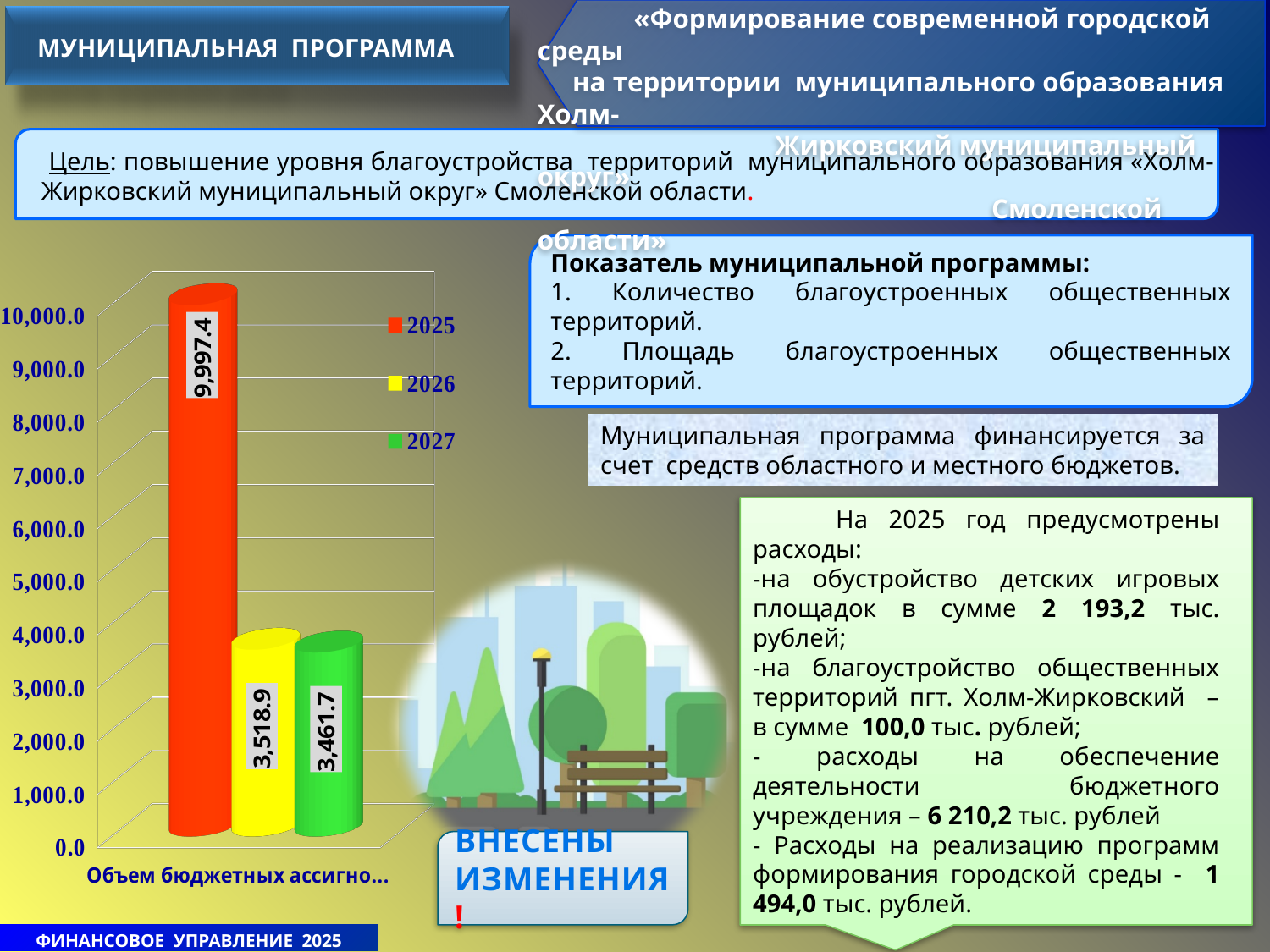
Which is larger, the value for 2025 or the value for 2027? 2025 What colour is the bar for 2026 in the chart? yellow How many series does the chart legend list? 3 What kind of chart is shown on the slide? bar chart Which year has the lowest value on the chart? 2027 What is the value for 2025 on the chart? 9,997.4 Which year has the highest value on the chart? 2025 Is the value for 2026 greater or less than 3,000.0? greater What is the value for 2027 on the chart? 3,461.7 What is the difference between the values for 2026 and 2027? 57.2 What is the value for 2026 on the chart? 3,518.9 What is the difference between the values for 2025 and 2026? 6,478.5